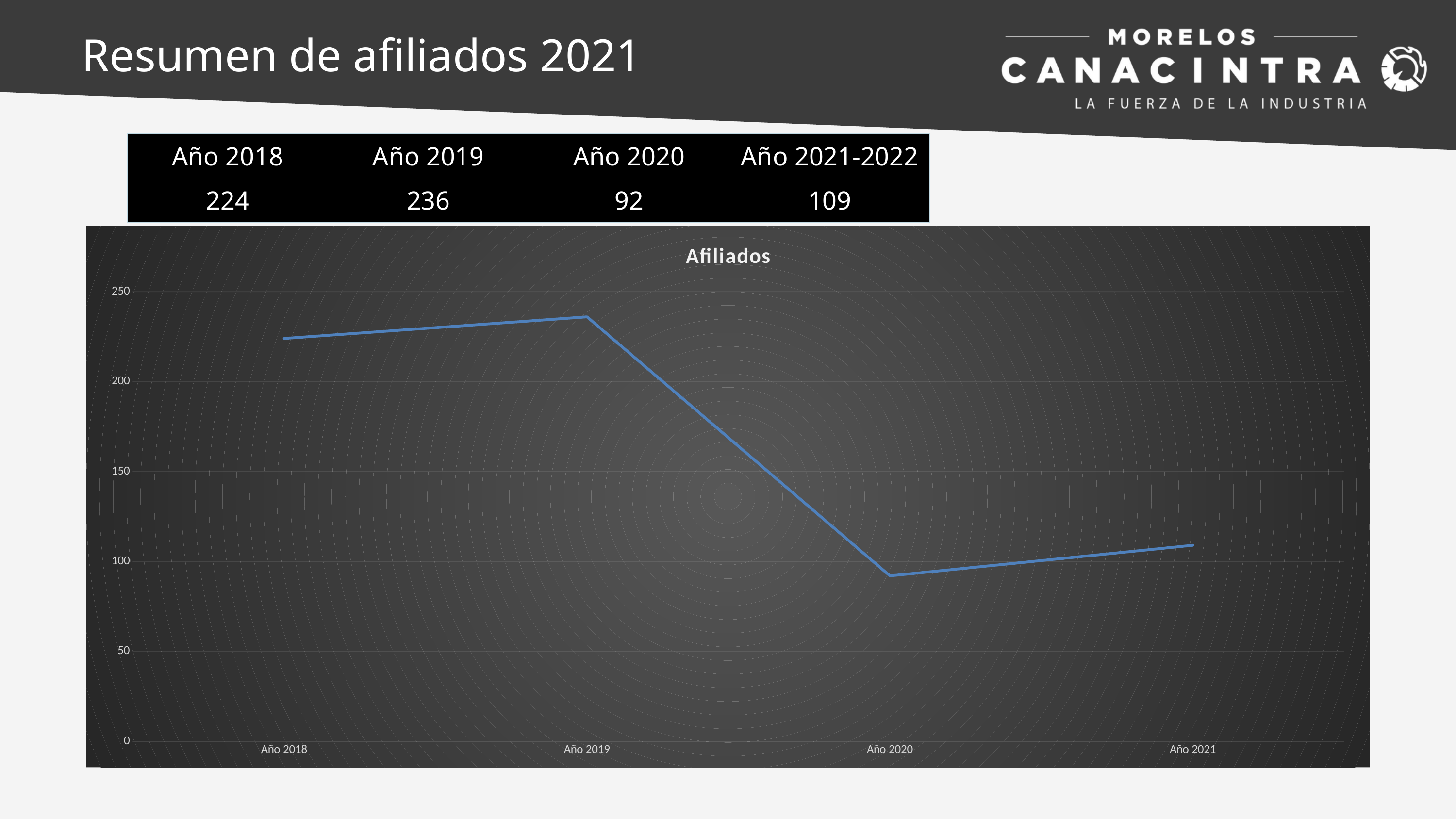
How many points are plotted on the line in the Afiliados chart? 4 According to the slide, what is the number of afiliados for Año 2018? 224 Does the line in the Afiliados chart rise or fall between Año 2019 and Año 2020? fall Which year has the lowest number of afiliados in the chart? Año 2020 According to the slide, what is the number of afiliados for Año 2019? 236 Which has more afiliados, Año 2018 or Año 2021? Año 2018 What is the title of the chart? Afiliados What kind of chart is shown on the slide? line chart Which year has the highest number of afiliados in the chart? Año 2019 According to the slide, what is the number of afiliados for Año 2020? 92 Is the value for Año 2020 in the Afiliados chart greater or less than 100? less What is the difference in afiliados between Año 2019 and Año 2020? 144